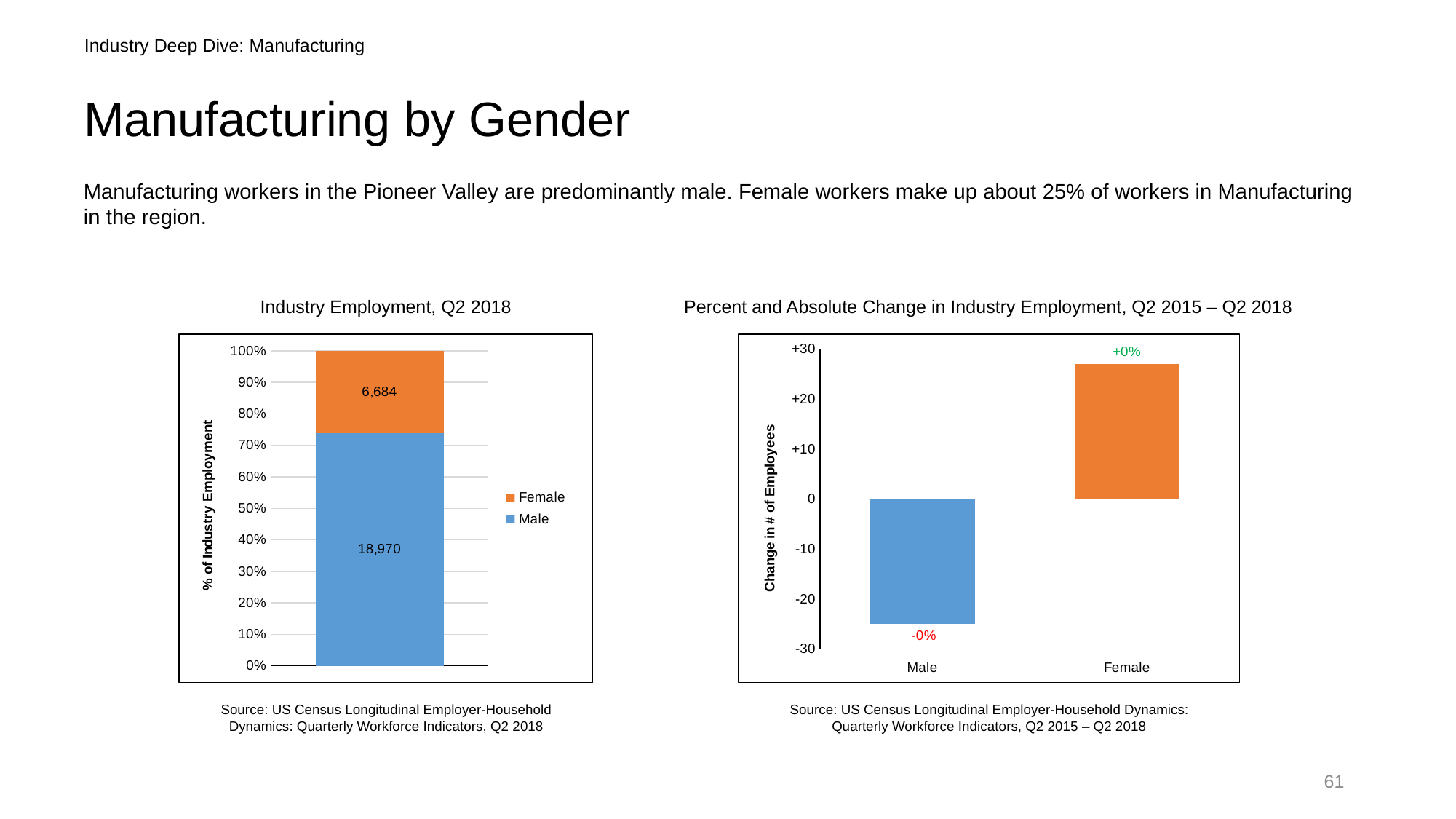
In the 'Industry Employment, Q2 2018' chart, what is the value shown for Female? 6,684 In the 'Industry Employment, Q2 2018' chart, which colour represents Female? Orange In the 'Industry Employment, Q2 2018' chart, what is the difference between the Male and Female values? 12,286 What kind of chart is the 'Percent and Absolute Change in Industry Employment, Q2 2015 – Q2 2018' chart? Bar chart In the 'Industry Employment, Q2 2018' chart, what is the value shown for Male? 18,970 In the 'Percent and Absolute Change in Industry Employment, Q2 2015 – Q2 2018' chart, how many categories are shown on the x axis? 2 In the 'Percent and Absolute Change in Industry Employment, Q2 2015 – Q2 2018' chart, which category shows a negative change? Male In the 'Industry Employment, Q2 2018' chart, how many series does the legend list? 2 In the 'Percent and Absolute Change in Industry Employment, Q2 2015 – Q2 2018' chart, is the value for Male greater or less than -20? less In the 'Industry Employment, Q2 2018' chart, what is the total of the stacked bar (Male plus Female)? 25,654 In the 'Percent and Absolute Change in Industry Employment, Q2 2015 – Q2 2018' chart, is the value for Female greater or less than +20? greater In the 'Industry Employment, Q2 2018' chart, which group has the larger value, Male or Female? Male